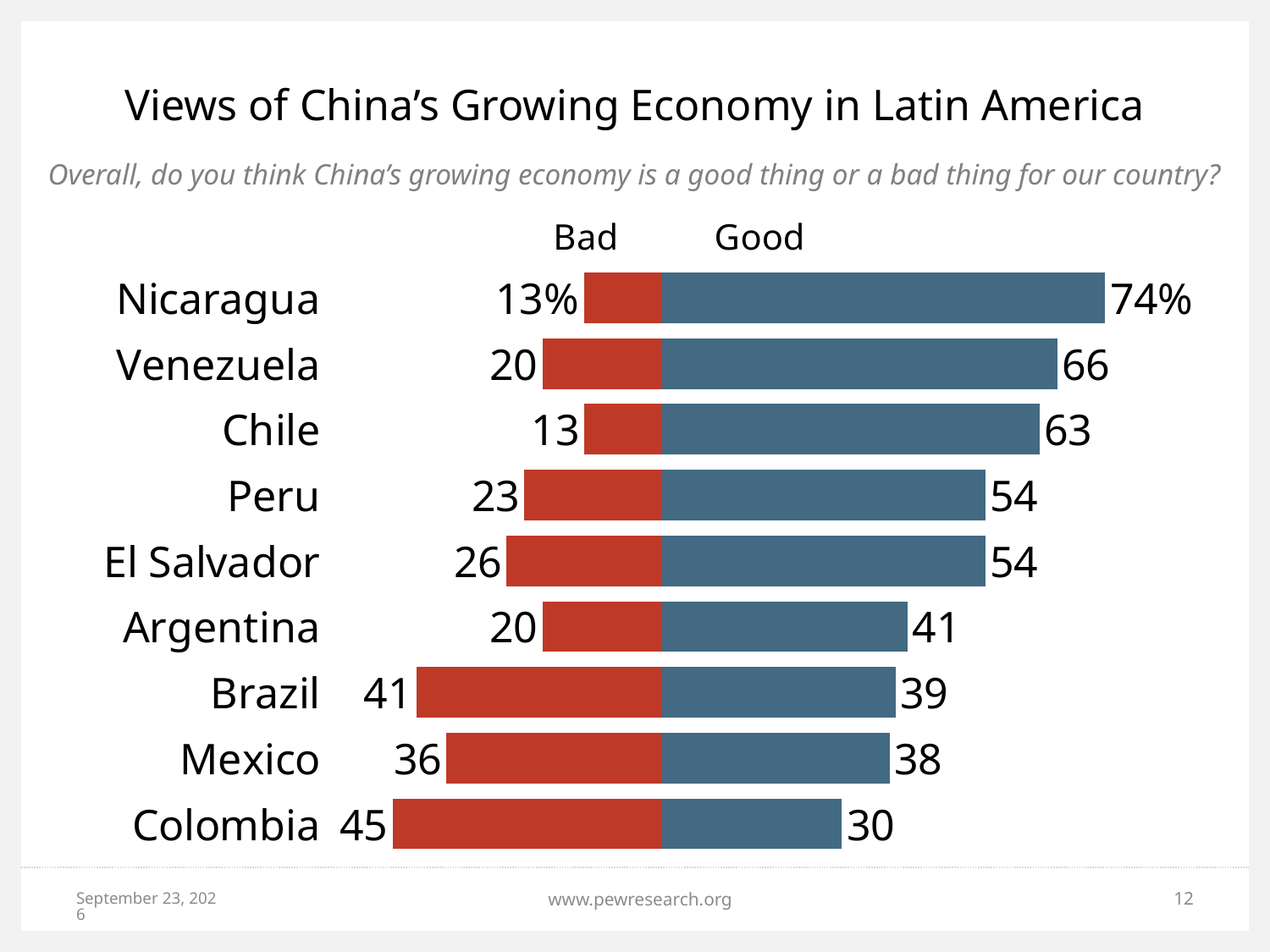
What percentage of respondents in Nicaragua say China's growing economy is a good thing? 74% Which is larger for Mexico, the 'Bad' value or the 'Good' value? Good What is the 'Good' value for Colombia? 30 What colour are the 'Bad' bars? Red Which country has the lowest 'Good' value? Colombia What is the difference between the 'Good' and 'Bad' values for Venezuela? 46 What is the 'Bad' value for Brazil? 41 Which country has the highest 'Bad' value? Colombia How many countries are shown in the chart? 9 How many series does the chart show? 2 Which country has the highest 'Good' value? Nicaragua What type of chart is shown on the slide? Bar chart